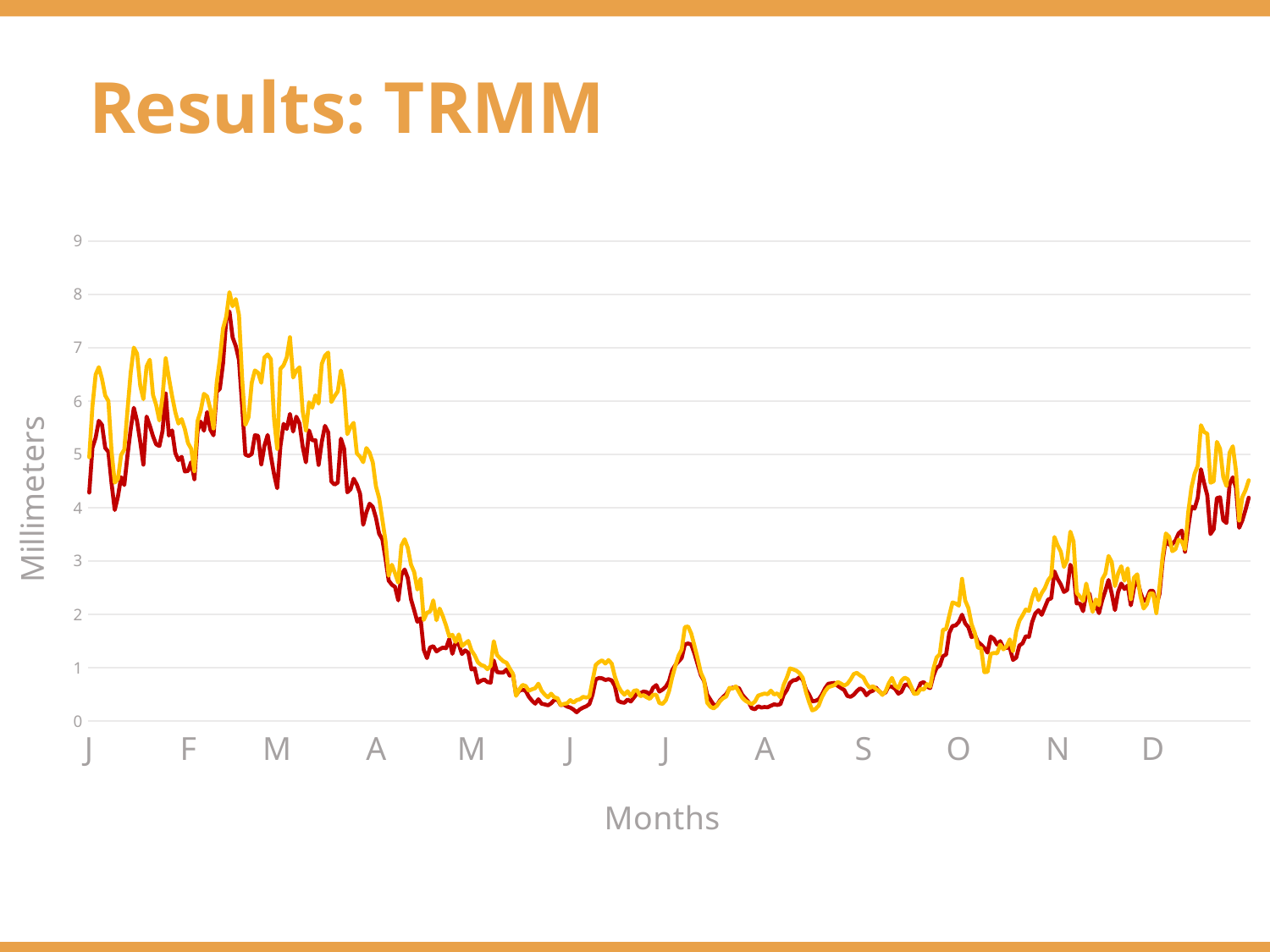
Is the value of the yellow line at the F tick greater or less than 4? greater Around the F tick, which line is higher, the yellow or the red? yellow How many month labels are shown along the x axis? 12 What kind of chart is shown on the slide? line chart How many lines are plotted on the chart? 2 What unit is given on the y-axis label of the chart? Millimeters Between the M (March) tick and the J (June) tick, do the values rise or fall? fall Is the value of the red line at the A (August) tick greater or less than 2? less Is the value of the yellow line at the June (second J) tick greater or less than 1? less What is the title of the slide containing the chart? Results: TRMM Between the S tick and the D tick, do the values rise or fall? rise